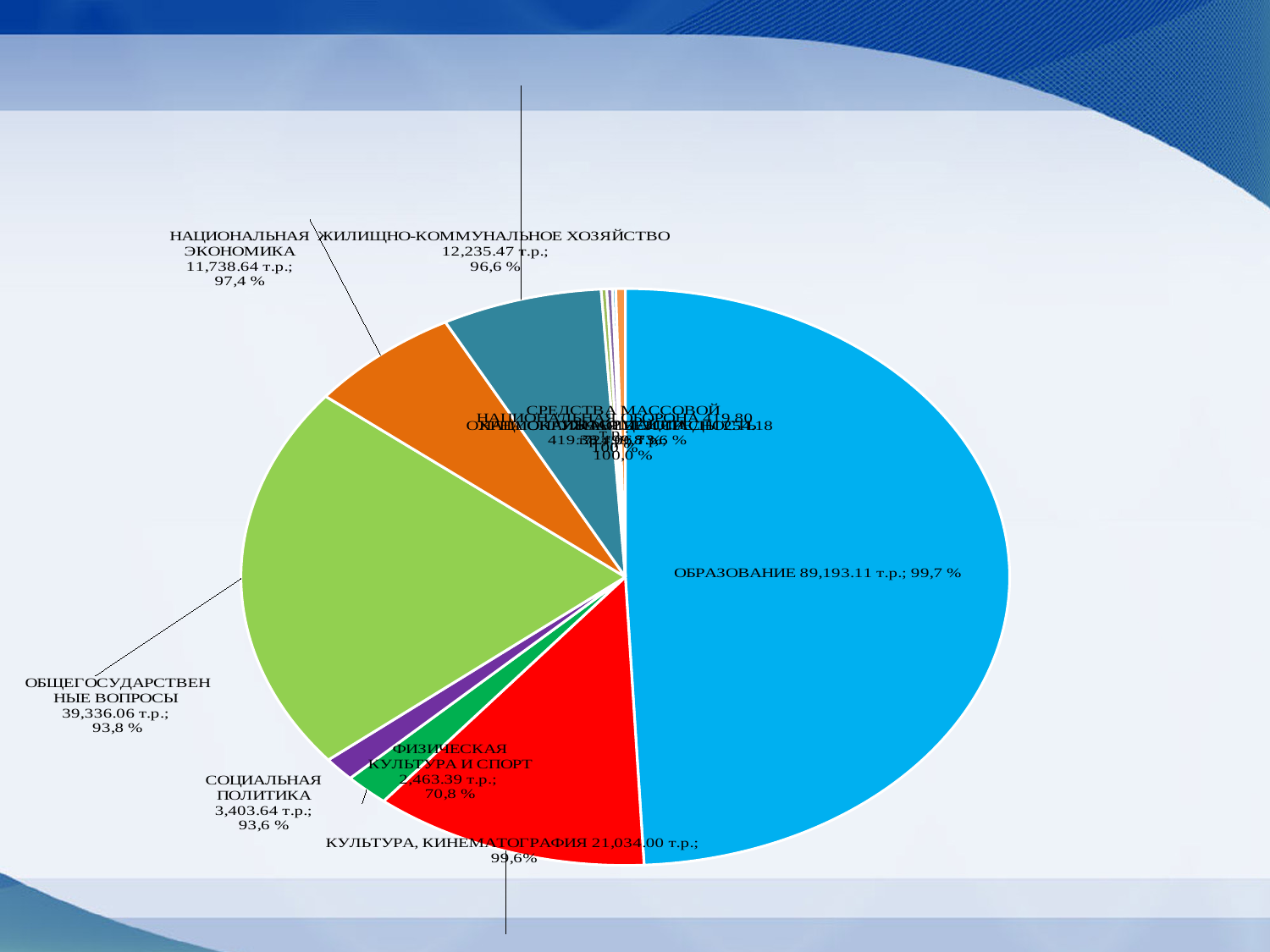
What percentage is shown for ОБРАЗОВАНИЕ? 99,7 % What amount is shown for КУЛЬТУРА, КИНЕМАТОГРАФИЯ? 21,034.00 т.р. What kind of chart is shown on the slide? pie chart Which category has the largest slice of the pie? ОБРАЗОВАНИЕ What is the difference in amount between ЖИЛИЩНО-КОММУНАЛЬНОЕ ХОЗЯЙСТВО and НАЦИОНАЛЬНАЯ ЭКОНОМИКА? 496.83 т.р. What percentage is shown for ЖИЛИЩНО-КОММУНАЛЬНОЕ ХОЗЯЙСТВО? 96,6 % What amount is shown for ОБРАЗОВАНИЕ? 89,193.11 т.р. Which has the larger amount, НАЦИОНАЛЬНАЯ ЭКОНОМИКА or ЖИЛИЩНО-КОММУНАЛЬНОЕ ХОЗЯЙСТВО? ЖИЛИЩНО-КОММУНАЛЬНОЕ ХОЗЯЙСТВО What percentage is shown for ФИЗИЧЕСКАЯ КУЛЬТУРА И СПОРТ? 70,8 % What amount is shown for ОБЩЕГОСУДАРСТВЕННЫЕ ВОПРОСЫ? 39,336.06 т.р. What is the difference in amount between ОБРАЗОВАНИЕ and ОБЩЕГОСУДАРСТВЕННЫЕ ВОПРОСЫ? 49,857.05 т.р. What amount is shown for СОЦИАЛЬНАЯ ПОЛИТИКА? 3,403.64 т.р.